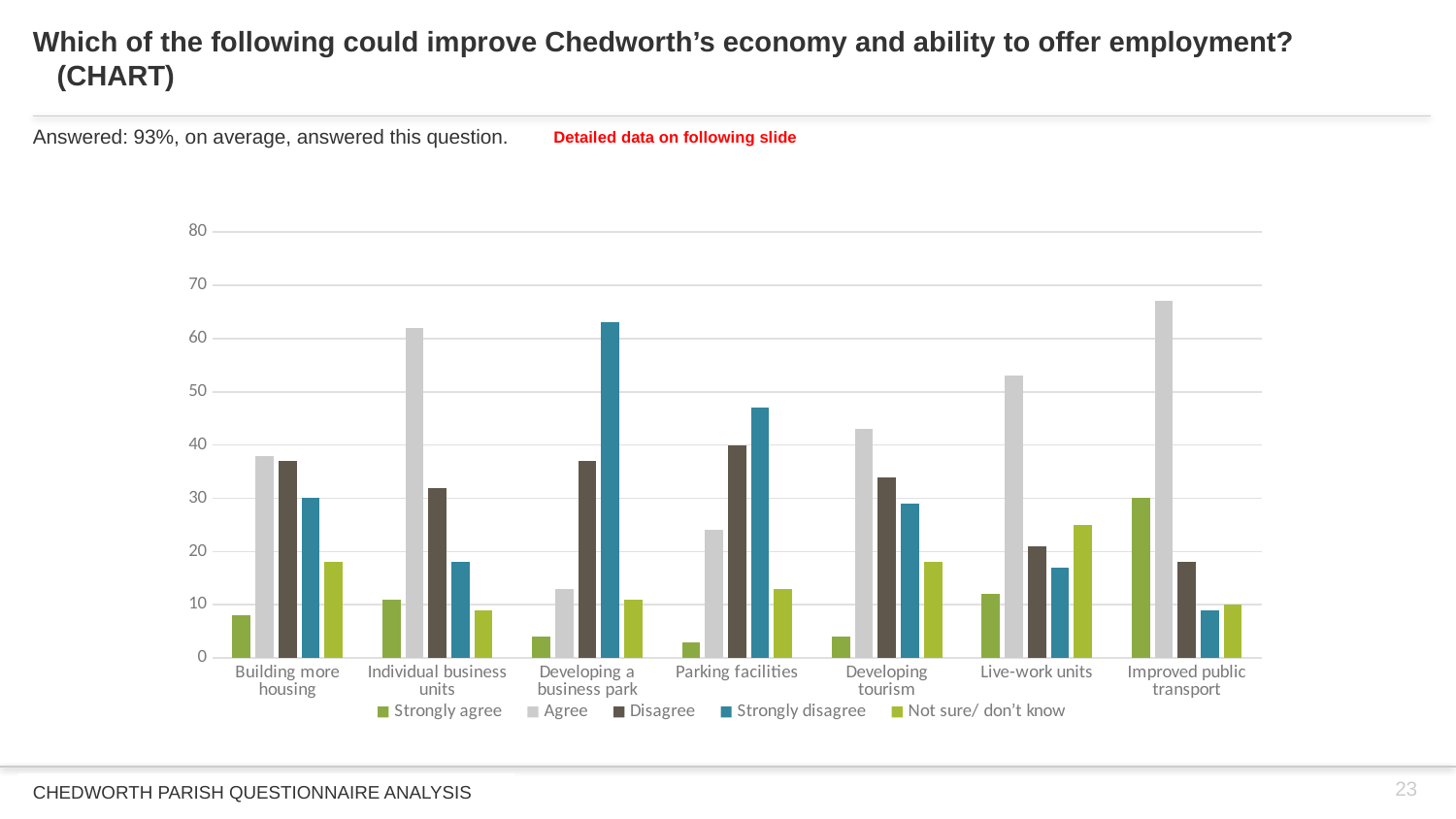
How many series does the chart's legend list? 5 What type of chart is shown on the slide? Bar chart How many categories are shown along the x axis of the chart? 7 Is the Not sure/ don't know value for Live-work units greater or less than 20? greater Which category has the highest Agree value? Improved public transport Which category has the highest Strongly disagree value? Developing a business park Is the Agree value for Live-work units greater or less than 50? greater Which category has the highest Strongly agree value? Improved public transport Is the Strongly disagree value for Developing a business park greater or less than 60? greater For Parking facilities, which is larger: the Disagree value or the Strongly disagree value? Strongly disagree For Developing a business park, which is larger: the Agree value or the Strongly disagree value? Strongly disagree